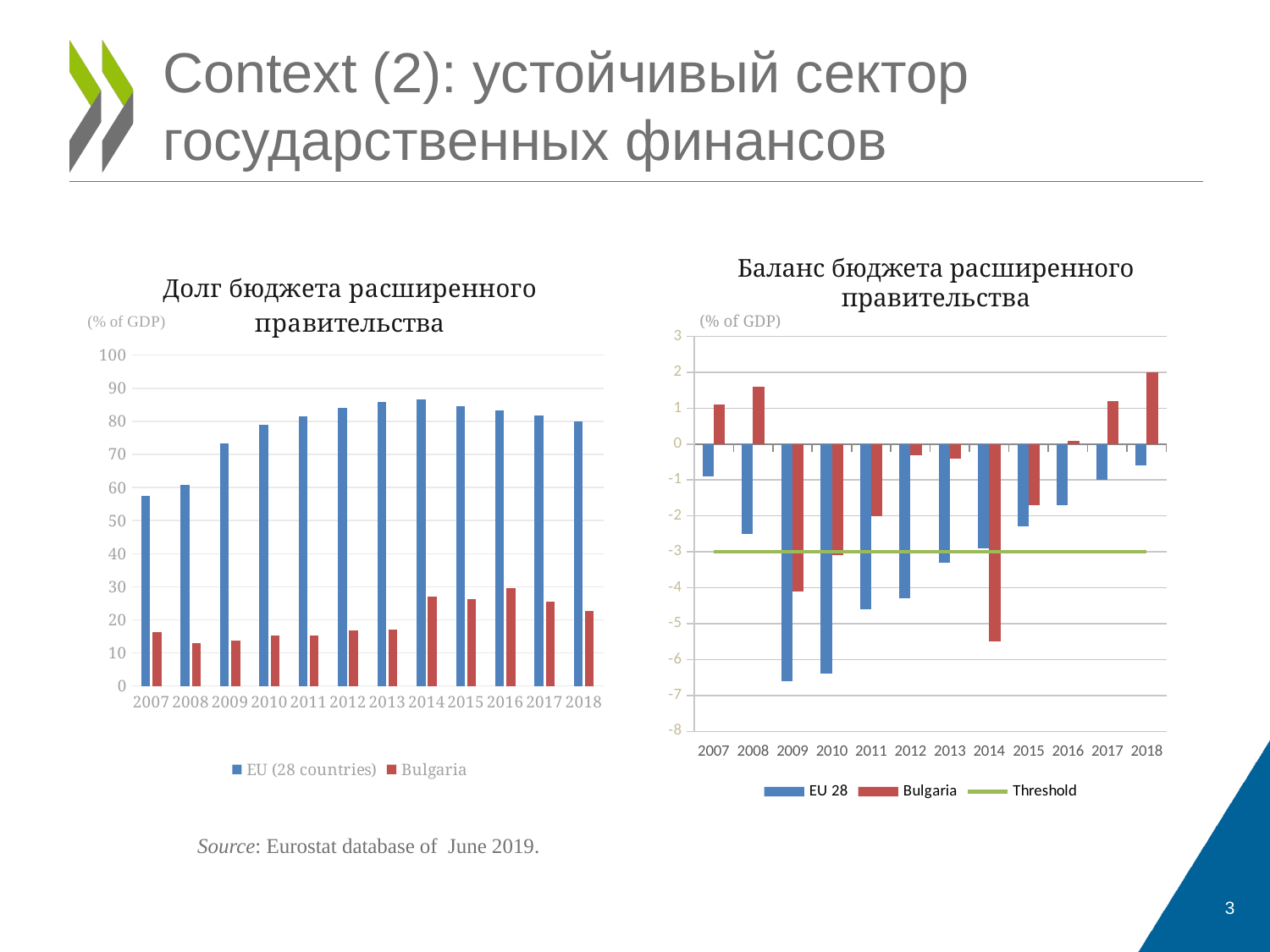
In the right chart (Баланс бюджета расширенного правительства), at what value is the Threshold line drawn? -3 In the right chart (Баланс бюджета расширенного правительства), is the value for EU 28 in 2009 greater or less than -6? less In the left chart (Долг бюджета расширенного правительства), which is larger in 2014: EU (28 countries) or Bulgaria? EU (28 countries) In the right chart (Баланс бюджета расширенного правительства), in which year is the Bulgaria value highest? 2018 In the right chart (Баланс бюджета расширенного правительства), how many series does the legend list? 3 In the right chart (Баланс бюджета расширенного правительства), in which year is the Bulgaria value lowest? 2014 In the left chart (Долг бюджета расширенного правительства), is the value for EU (28 countries) in 2007 greater or less than 50? greater In the left chart (Долг бюджета расширенного правительства), do the EU (28 countries) values rise or fall from 2007 to 2014? rise What kind of chart is the left chart titled 'Долг бюджета расширенного правительства'? bar chart In the left chart (Долг бюджета расширенного правительства), how many years are shown on the x axis? 12 In the left chart (Долг бюджета расширенного правительства), how many series does the legend list? 2 In the left chart (Долг бюджета расширенного правительства), is the value for Bulgaria in 2008 greater or less than 20? less